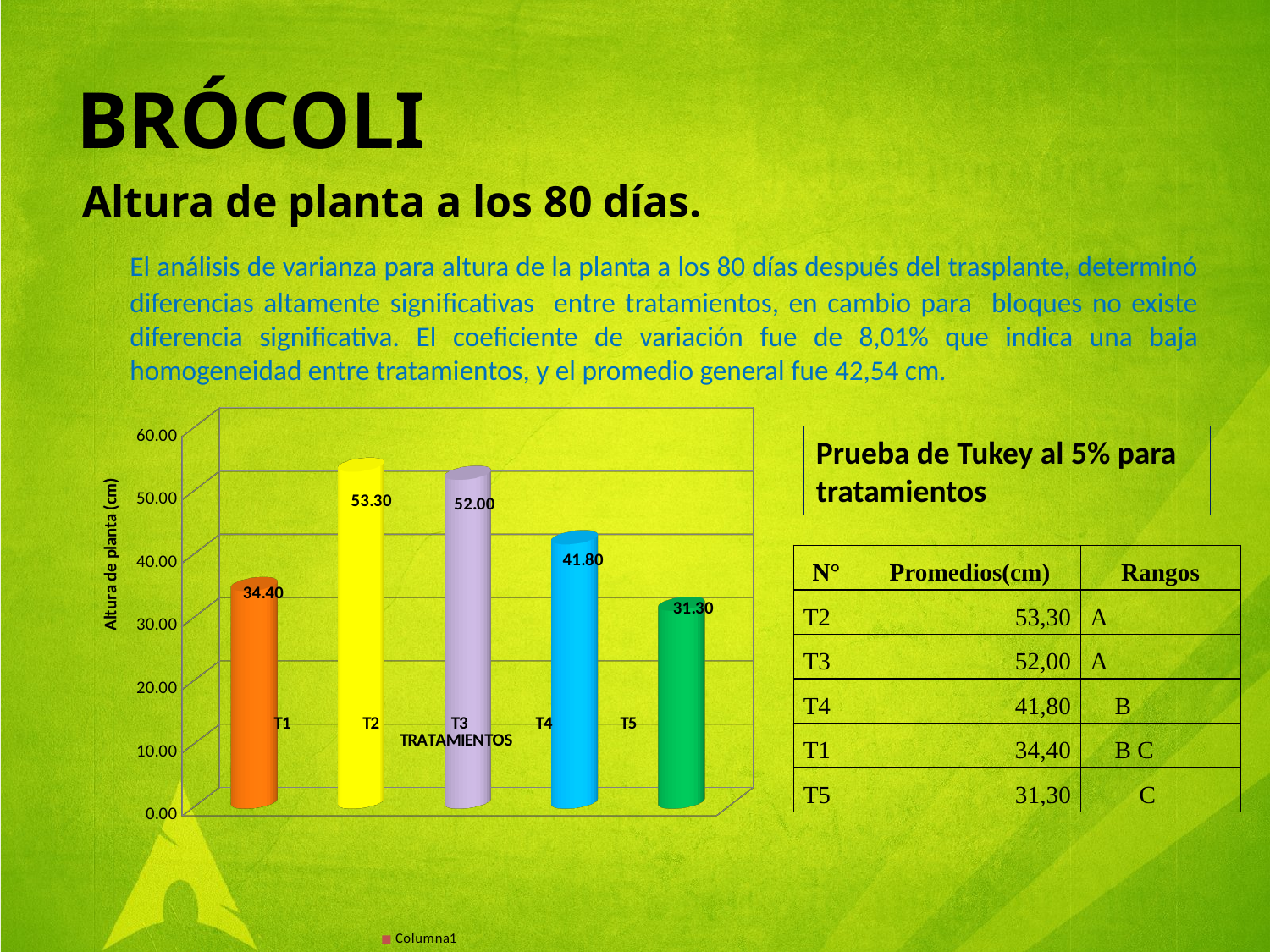
Which treatment has the highest plant height? T2 Is the value for T3 greater or less than 50.00? greater What is the plant height value for treatment T4? 41.80 Which treatment has the lowest plant height? T5 What is the plant height value for treatment T5? 31.30 How many treatments are shown on the x axis of the chart? 5 Which is larger, the value for T1 or the value for T4? T4 What is the difference between the values for T4 and T1? 7.40 What kind of chart is shown on the slide? bar chart What is the label of the y axis of the chart? Altura de planta (cm) What is the plant height value for treatment T2? 53.30 What is the difference between the values for T2 and T5? 22.00